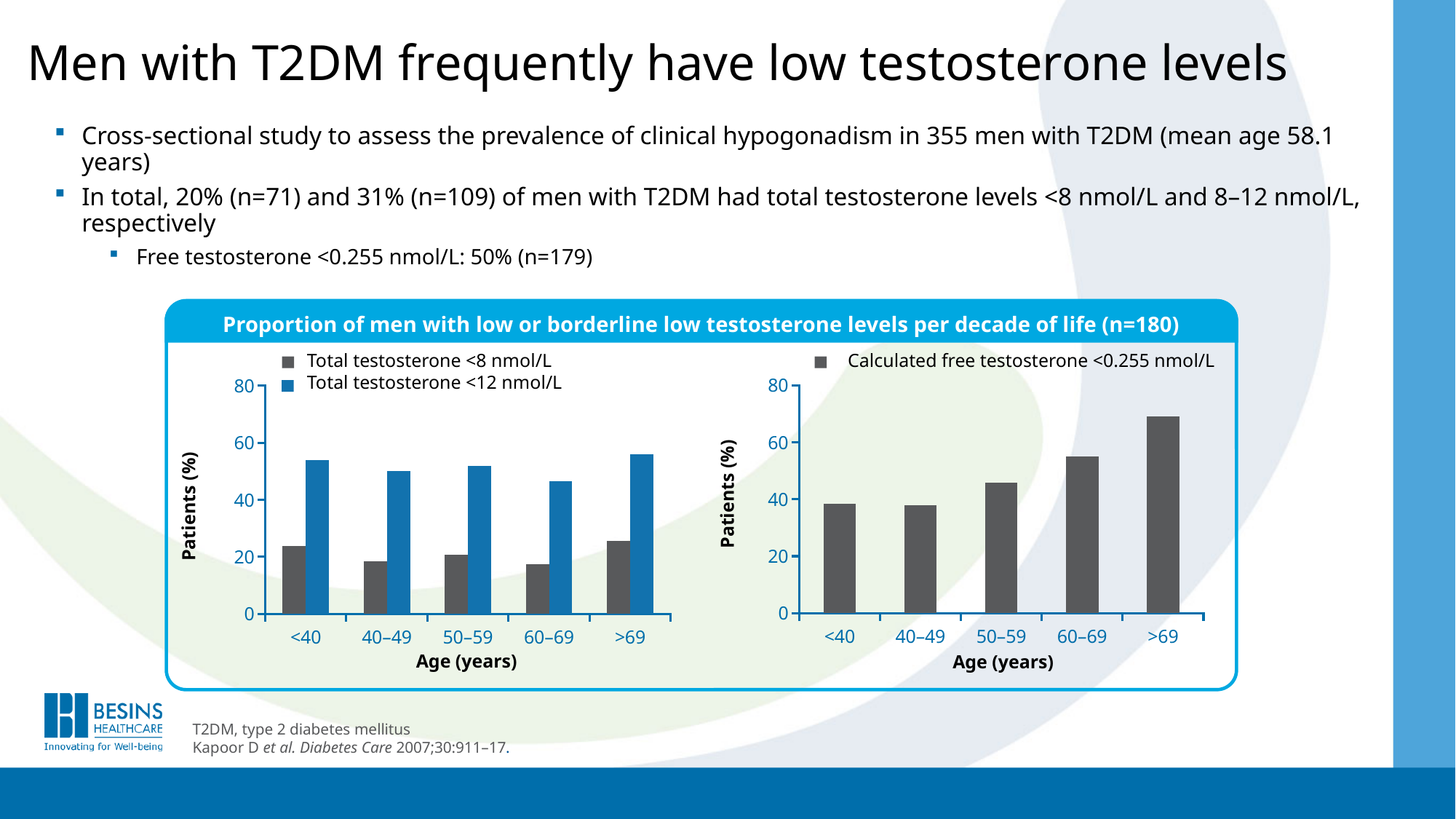
What kind of chart is the left chart on the slide? bar chart In the left chart, is the value for Total testosterone <8 nmol/L in the <40 age group greater or less than 20? greater How many series does the legend of the left chart list? 2 In the left chart, for the <40 age group, which series has the larger value: Total testosterone <8 nmol/L or Total testosterone <12 nmol/L? Total testosterone <12 nmol/L In the left chart, which age group has the lowest value for Total testosterone <12 nmol/L? 60–69 In the right chart (Calculated free testosterone <0.255 nmol/L), which age group has the highest proportion of patients? >69 In the left chart, is the value for Total testosterone <12 nmol/L in the 60–69 age group greater or less than 60? less In the right chart, do the values generally rise or fall as age increases along the x axis? rise How many age categories are shown on the x axis of the right chart? 5 In the right chart, is the value for the >69 age group greater or less than 60? greater What is the title shown above the two charts? Proportion of men with low or borderline low testosterone levels per decade of life (n=180)